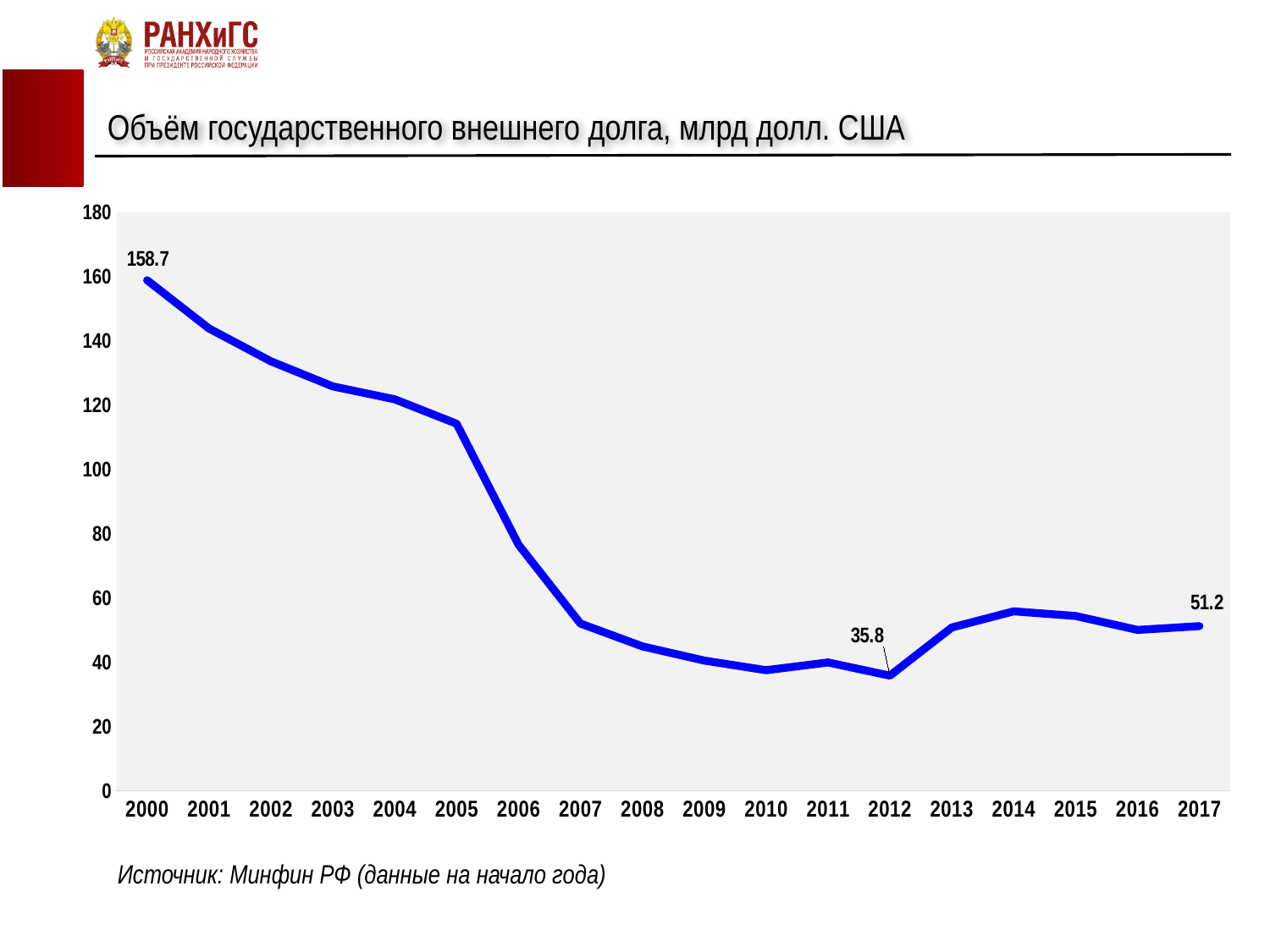
What is the value for 2000? 158.7 Which year has the lowest value? 2012 What is the value for 2017? 51.2 What is the difference between the values for 2017 and 2012? 15.4 Which is larger, the value for 2005 or the value for 2010? 2005 Is the value for 2006 greater or less than 60? greater How many years are shown on the x axis? 18 What is the value for 2012? 35.8 What kind of chart is this? line chart What is the difference between the values for 2000 and 2017? 107.5 Which year has the highest value? 2000 Is the value for 2009 greater or less than 60? less